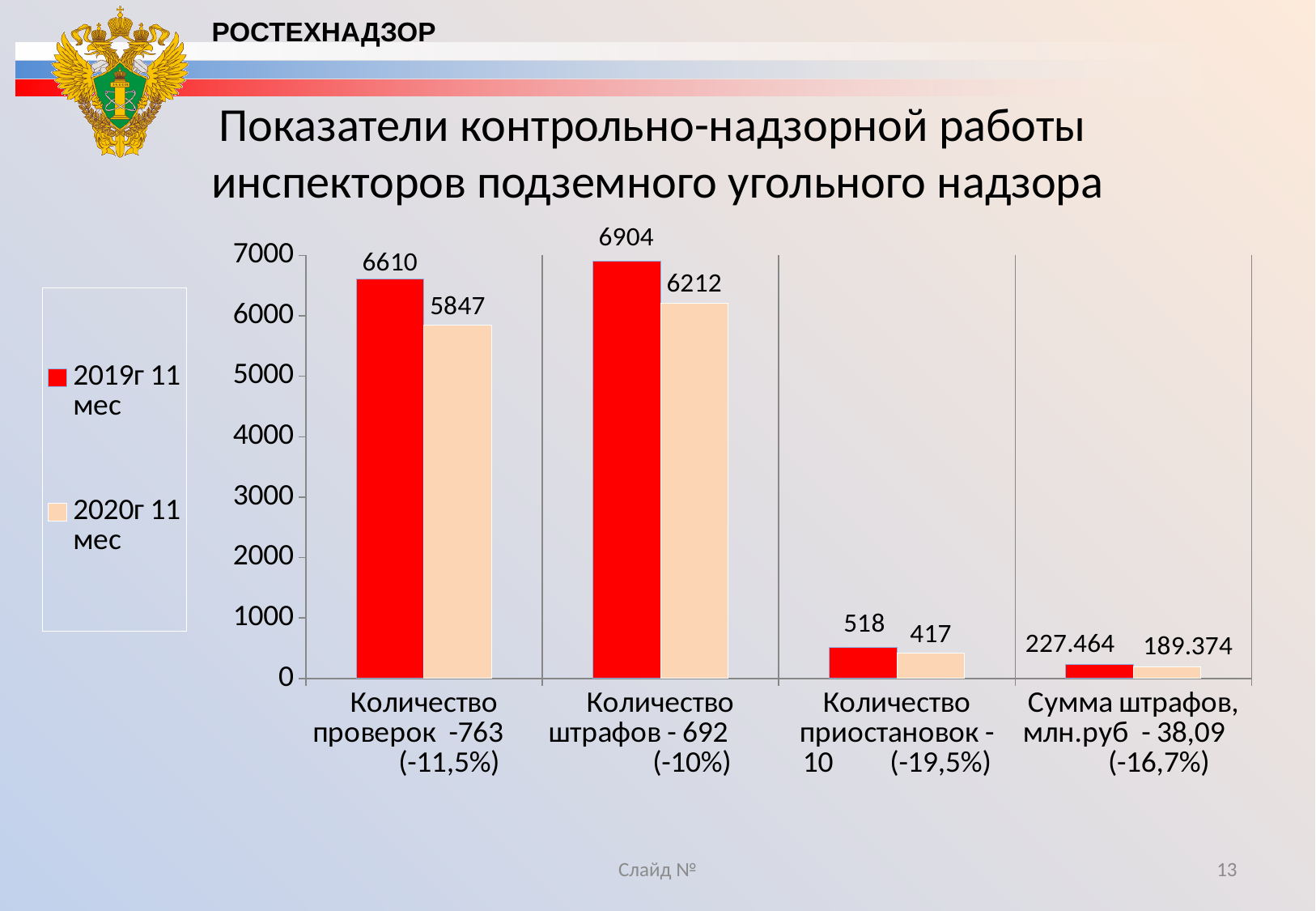
What is the difference between the '2019г 11 мес' and '2020г 11 мес' values for 'Количество приостановок'? 101 What is the value for 'Количество проверок' in the '2019г 11 мес' series? 6610 What is the value for 'Количество штрафов' in the '2020г 11 мес' series? 6212 What colour are the bars for the '2019г 11 мес' series? red Which category has the highest value in the '2019г 11 мес' series? Количество штрафов What is the value for 'Количество приостановок' in the '2019г 11 мес' series? 518 How many categories are shown on the x axis? 4 What is the value for 'Сумма штрафов, млн.руб' in the '2020г 11 мес' series? 189.374 How many series does the legend list? 2 What type of chart is shown on the slide? bar chart Which is larger for 'Количество проверок': the '2019г 11 мес' value or the '2020г 11 мес' value? 2019г 11 мес Which category has the lowest value in the '2020г 11 мес' series? Сумма штрафов, млн.руб